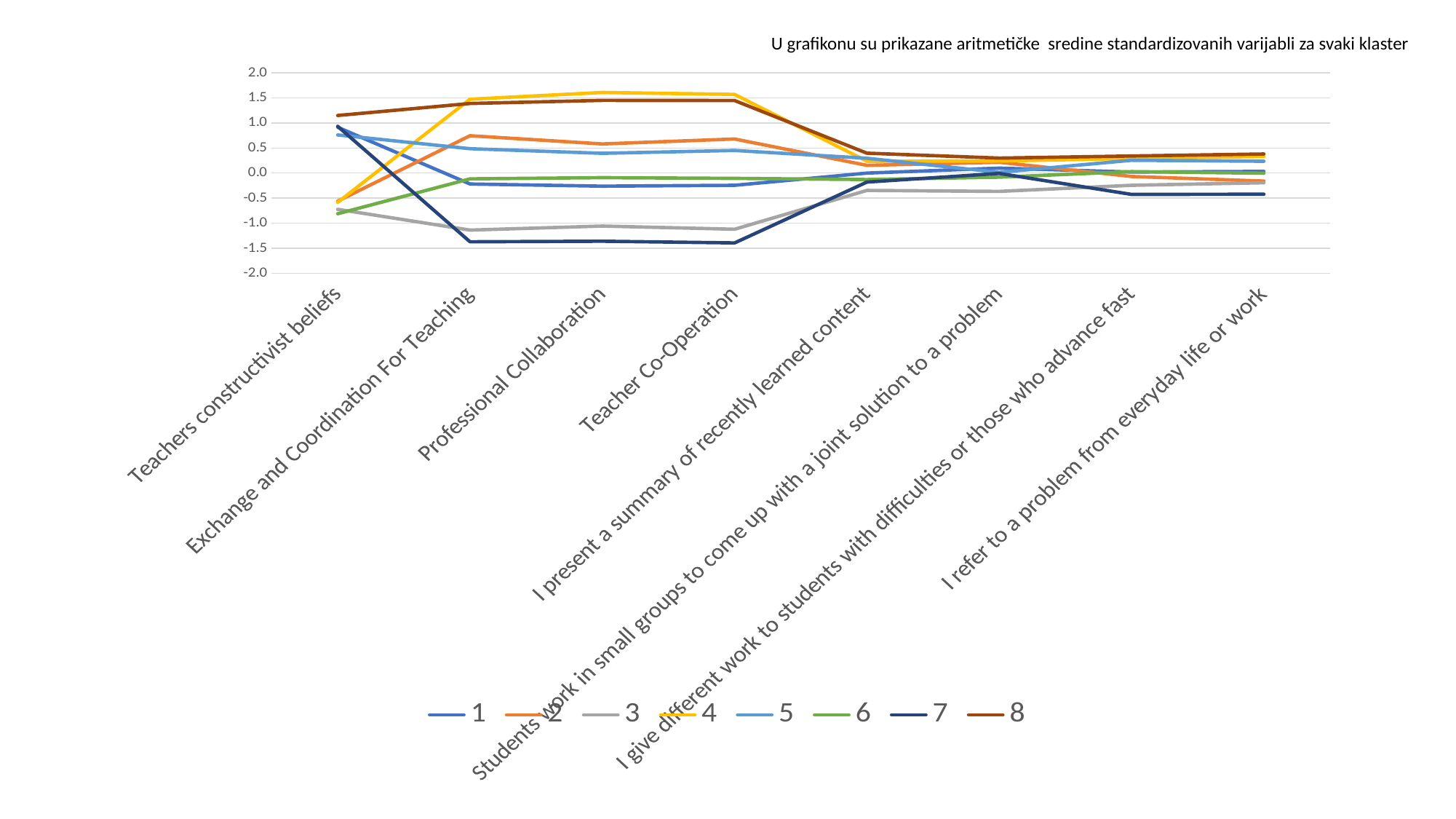
What is the text shown above the chart? U grafikonu su prikazane aritmetičke sredine standardizovanih varijabli za svaki klaster Is the value for series 4 at Professional Collaboration greater or less than 1.5? greater How many series does the legend list? 8 Is the value for series 6 at Teachers constructivist beliefs greater or less than -0.5? less Is the value for series 8 at Teachers constructivist beliefs greater or less than 1.0? greater How many categories are shown along the x axis? 8 Which series has the lowest value at Professional Collaboration? 7 Does series 7 rise or fall from Teachers constructivist beliefs to Exchange and Coordination For Teaching? fall At Teacher Co-Operation, which is larger: the value for series 3 or the value for series 7? series 3 What kind of chart is shown on the slide? line chart Which series has the highest value at Teachers constructivist beliefs? 8